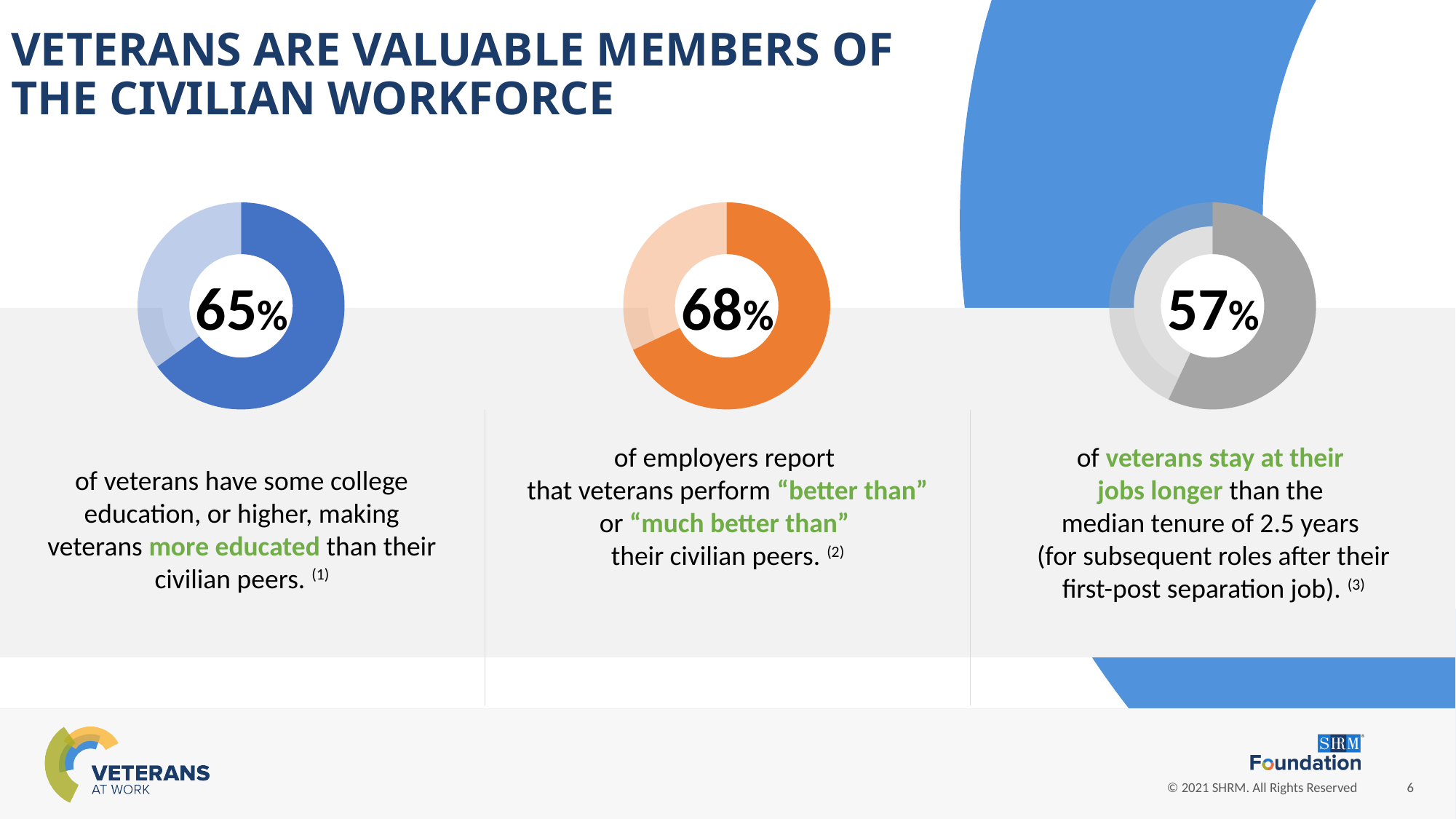
What percentage is shown in the left donut chart about veterans' college education? 65% Which of the three donut charts shows the highest percentage? The middle chart (68%) What percentage is shown in the middle donut chart about employers reporting veterans perform better than civilian peers? 68% What percentage is shown in the right donut chart about veterans staying at their jobs longer? 57% How many donut charts are shown on the slide? 3 Is the value in the left donut chart greater or less than 50%? greater What colour is the filled portion of the middle donut chart? Orange Which of the three donut charts shows the lowest percentage? The right chart (57%) What is the difference between the percentage in the middle donut chart and the percentage in the left donut chart? 3 percentage points What kind of chart is used to display the 65%, 68% and 57% figures? Donut (pie) chart What is the difference between the percentage in the left donut chart and the percentage in the right donut chart? 8 percentage points Is the percentage in the middle donut chart larger or smaller than the percentage in the right donut chart? Larger